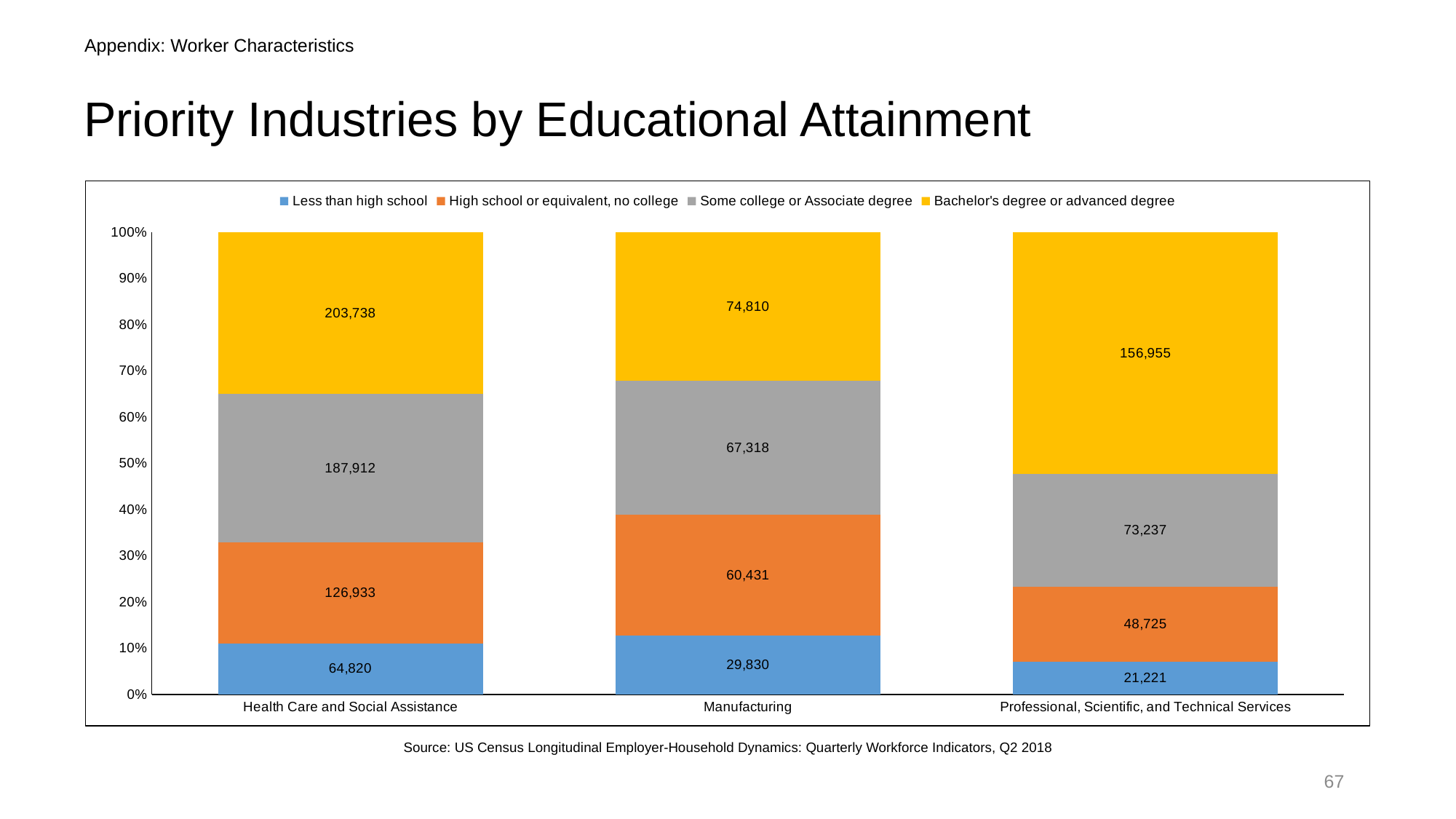
How many industries are shown on the x axis? 3 Is the share of Bachelor's degree or advanced degree in Professional, Scientific, and Technical Services greater or less than 50%? greater Which is larger: Some college or Associate degree in Manufacturing or in Professional, Scientific, and Technical Services? Professional, Scientific, and Technical Services What is the total of all four education levels for Manufacturing? 232,389 What is the value for Less than high school in Health Care and Social Assistance? 64,820 What is the value for Some college or Associate degree in Manufacturing? 67,318 Which industry has the highest value for High school or equivalent, no college? Health Care and Social Assistance What kind of chart is shown? Stacked bar chart How many series does the legend list? 4 What is the difference between the Bachelor's degree or advanced degree values for Health Care and Social Assistance and Professional, Scientific, and Technical Services? 46,783 Which industry has the lowest value for Less than high school? Professional, Scientific, and Technical Services What is the value for Bachelor's degree or advanced degree in Professional, Scientific, and Technical Services? 156,955